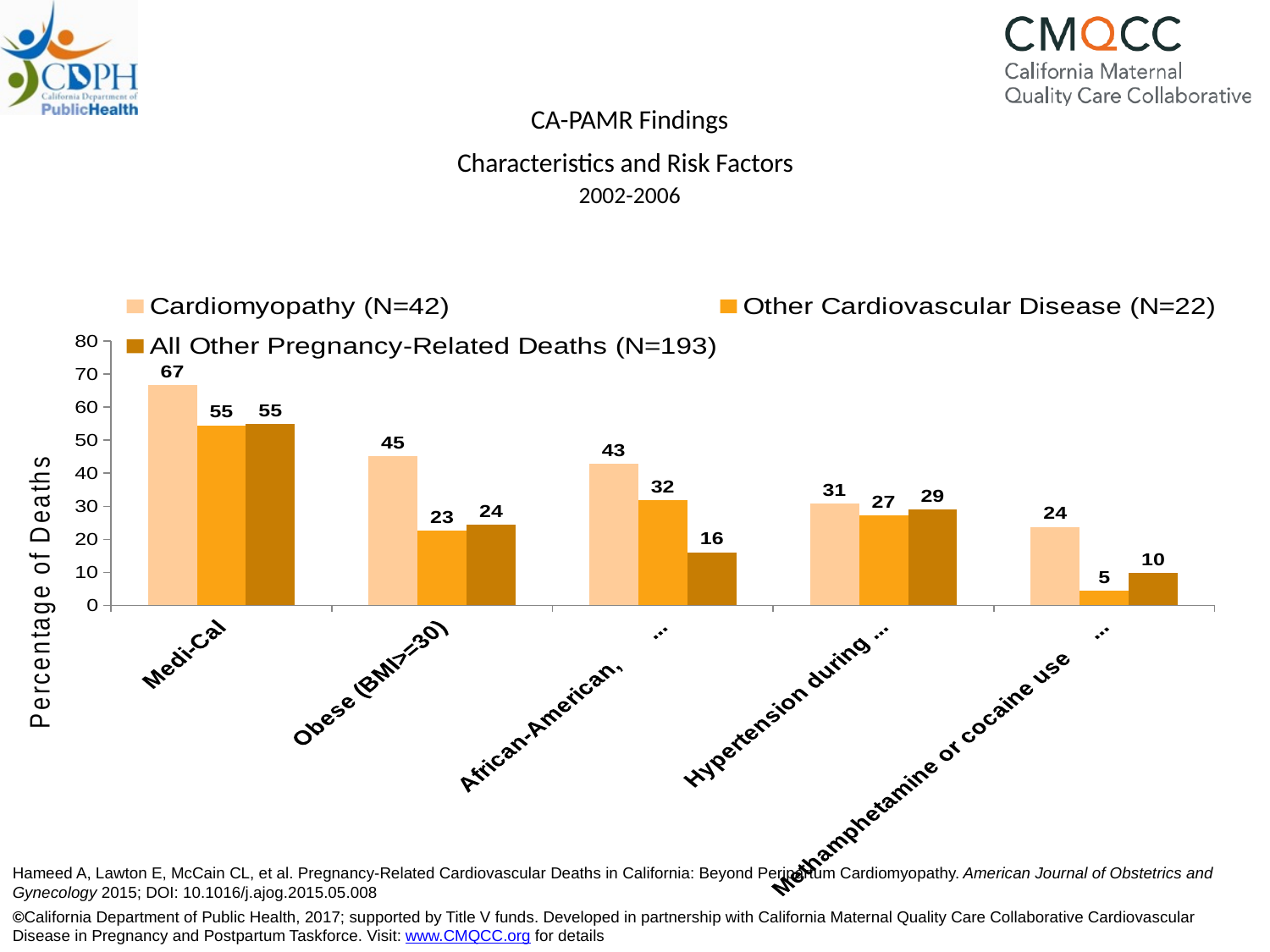
Is the Cardiomyopathy value for Obese (BMI>=30) greater or less than 40? greater What is the value for All Other Pregnancy-Related Deaths in the Methamphetamine or cocaine use category? 10 Which category has the highest value for the Cardiomyopathy series? Medi-Cal How many series does the legend list? 3 What is the label of the y axis? Percentage of Deaths Which category has the lowest value for the Other Cardiovascular Disease series? Methamphetamine or cocaine use What is the value for Other Cardiovascular Disease in the Obese (BMI>=30) category? 23 What kind of chart is shown on the slide? Bar chart How many categories are shown on the x axis? 5 What is the difference between the Cardiomyopathy and All Other Pregnancy-Related Deaths values in the African-American category? 27 What percentage of Cardiomyopathy deaths were Medi-Cal? 67 In the Hypertension during category, which is larger: Other Cardiovascular Disease or All Other Pregnancy-Related Deaths? All Other Pregnancy-Related Deaths